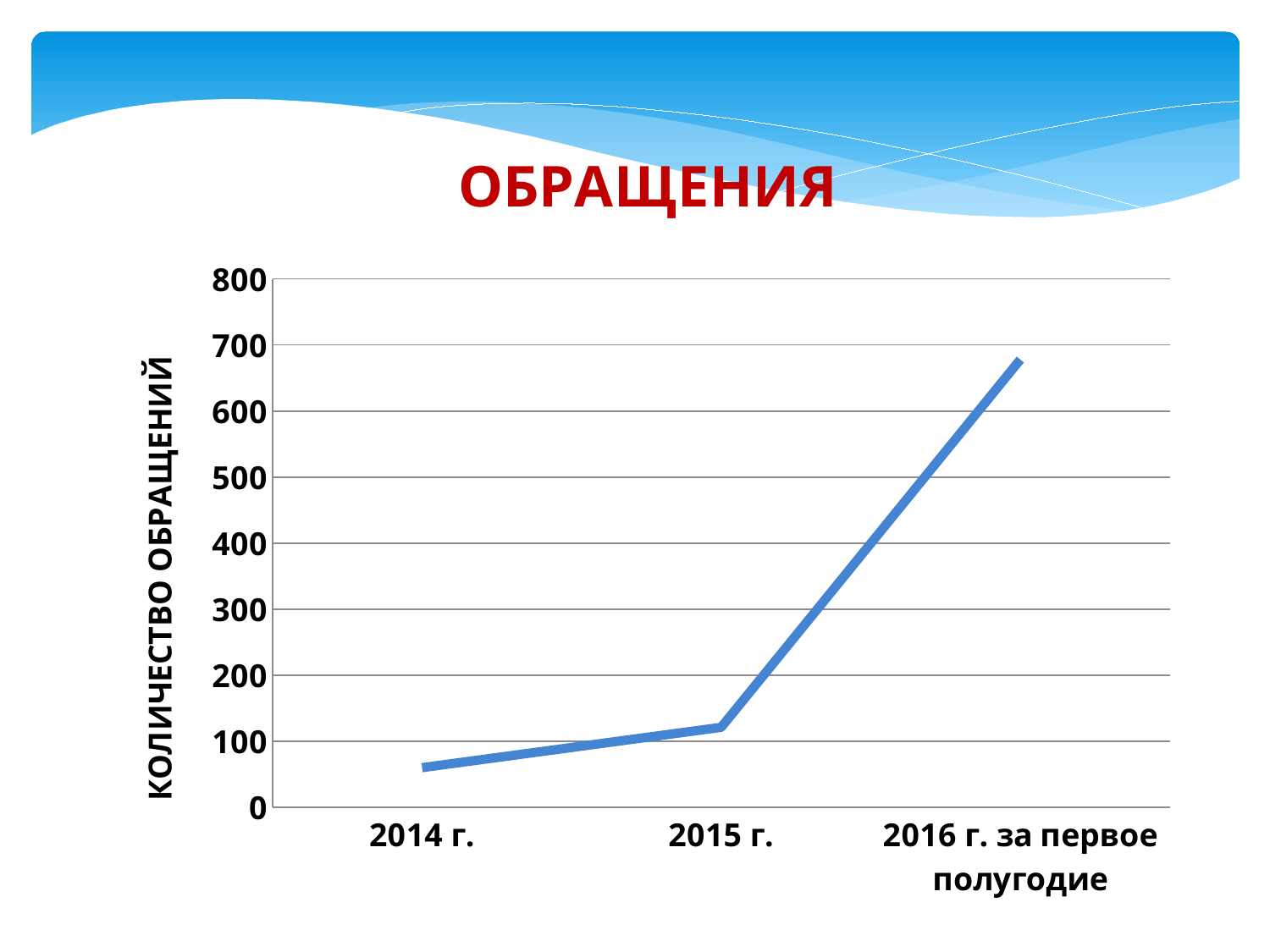
Which is larger, the value for 2014 г. or the value for 2015 г.? 2015 г. Is the value for 2016 г. за первое полугодие greater or less than 700? less Which category has the lowest value? 2014 г. Which category has the highest value? 2016 г. за первое полугодие What is the label on the vertical axis? КОЛИЧЕСТВО ОБРАЩЕНИЙ What is the title of the chart? ОБРАЩЕНИЯ Is the value for 2016 г. за первое полугодие greater or less than 600? greater What kind of chart is shown on the slide? line chart Is the value for 2015 г. greater or less than 200? less Do the values rise or fall from 2014 г. to 2016 г. за первое полугодие? rise How many data points are plotted on the line? 3